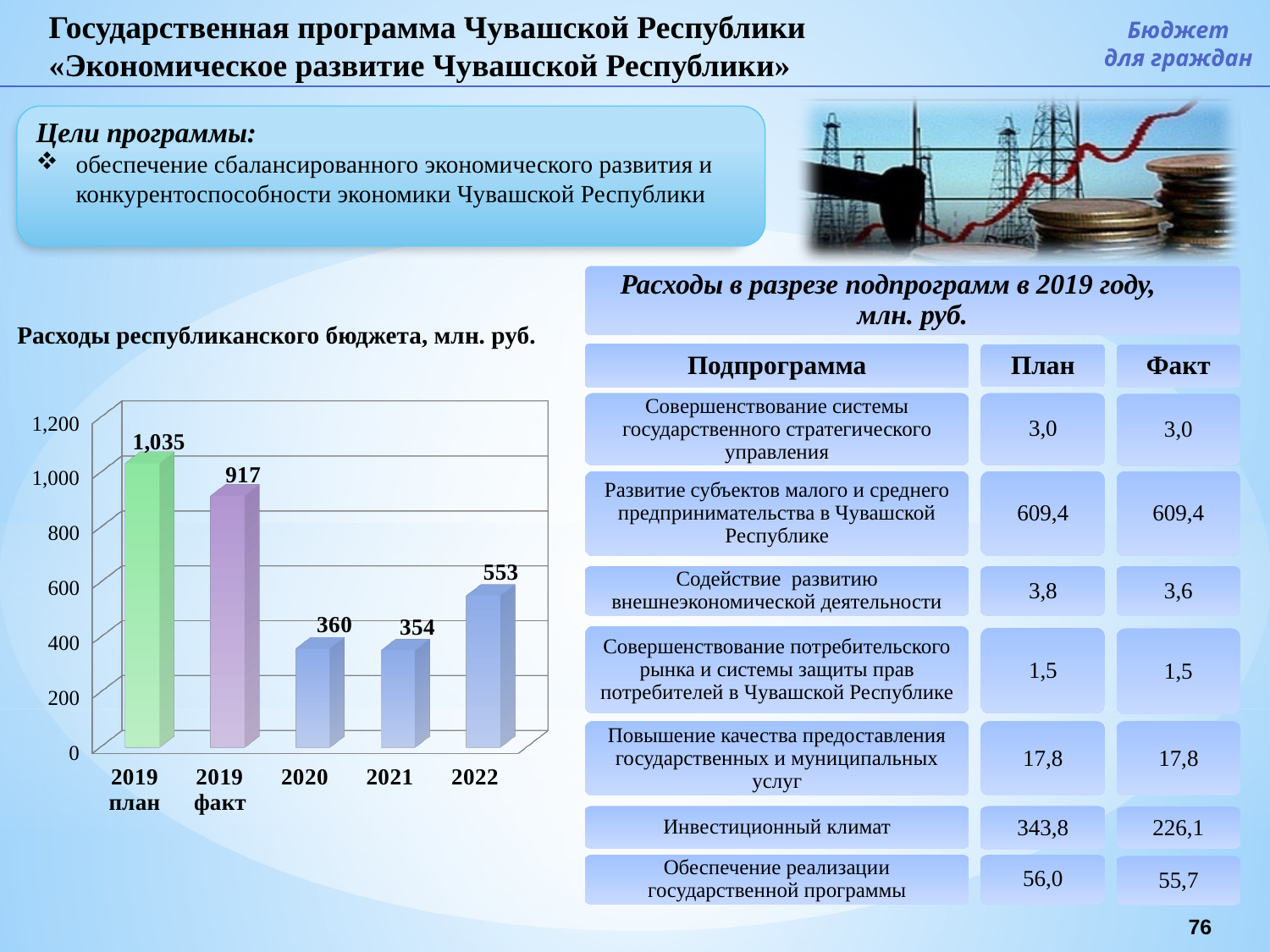
Which category has the highest value in the chart? 2019 план What is the difference between the 2022 and 2020 values? 193 Is the value for 2019 факт greater or less than 800? greater What is the value for 2022 in the chart? 553 Which is larger, the value for 2020 or the value for 2022? 2022 What is the value for 2021 in the chart? 354 What type of chart is shown on the slide? bar chart Which category has the lowest value in the chart? 2021 What is the value for 2019 факт in the chart? 917 What is the value for 2019 план in the chart 'Расходы республиканского бюджета, млн. руб.'? 1,035 How many bars are shown in the chart? 5 What is the difference between the 2019 план and 2019 факт values? 118